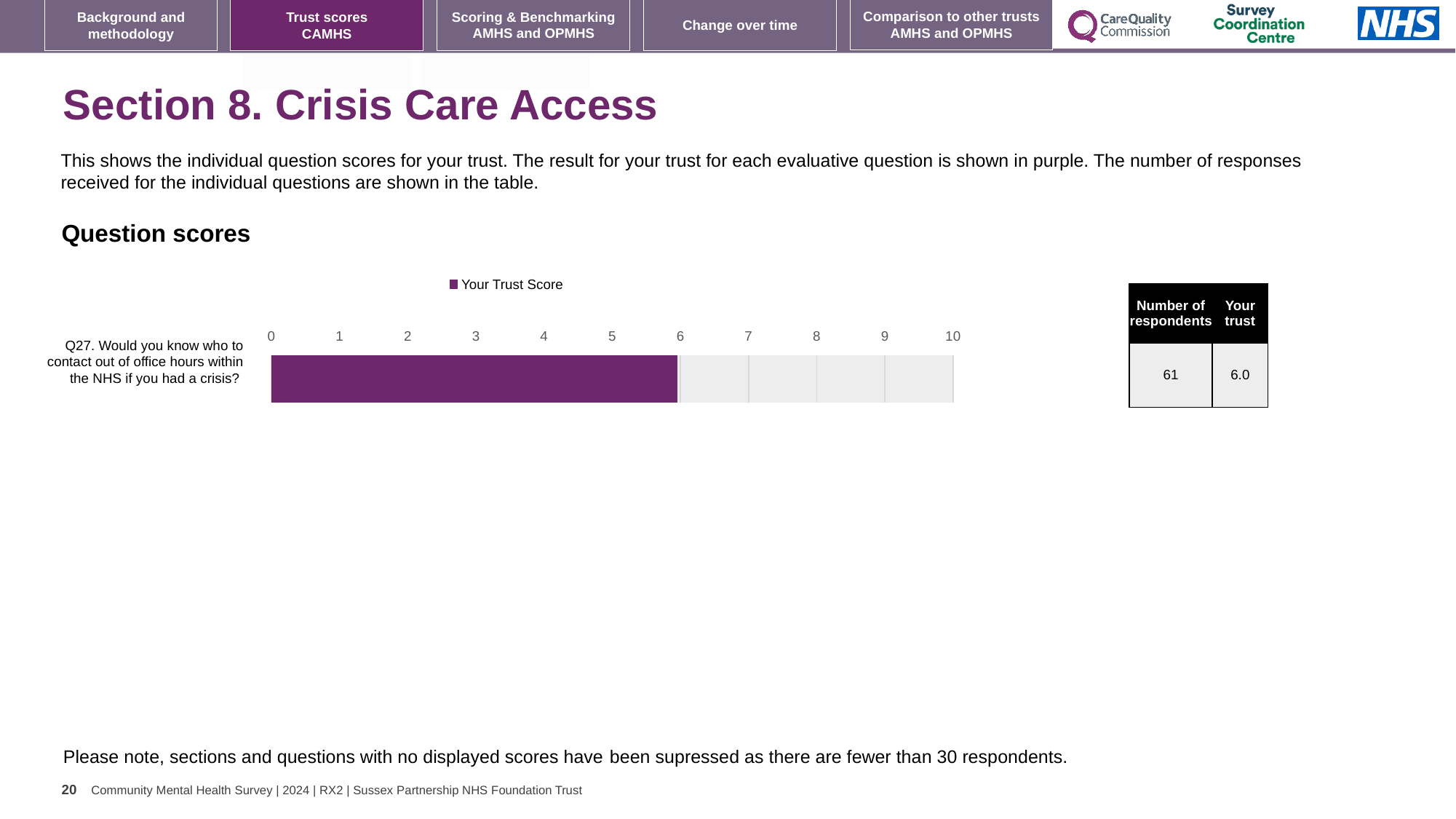
How many series does the chart legend list? 1 What colour is the bar representing the trust's score? purple What is the name of the series shown in the chart legend? Your Trust Score What is the maximum value shown on the chart's horizontal axis? 10 How many questions (categories) are plotted in the chart? 1 What kind of chart is shown under "Question scores"? bar chart What is the Your Trust Score for Q27 (Would you know who to contact out of office hours within the NHS if you had a crisis)? 6.0 Is the Your Trust Score for Q27 greater or less than 5? greater Is the Your Trust Score for Q27 greater or less than 8? less